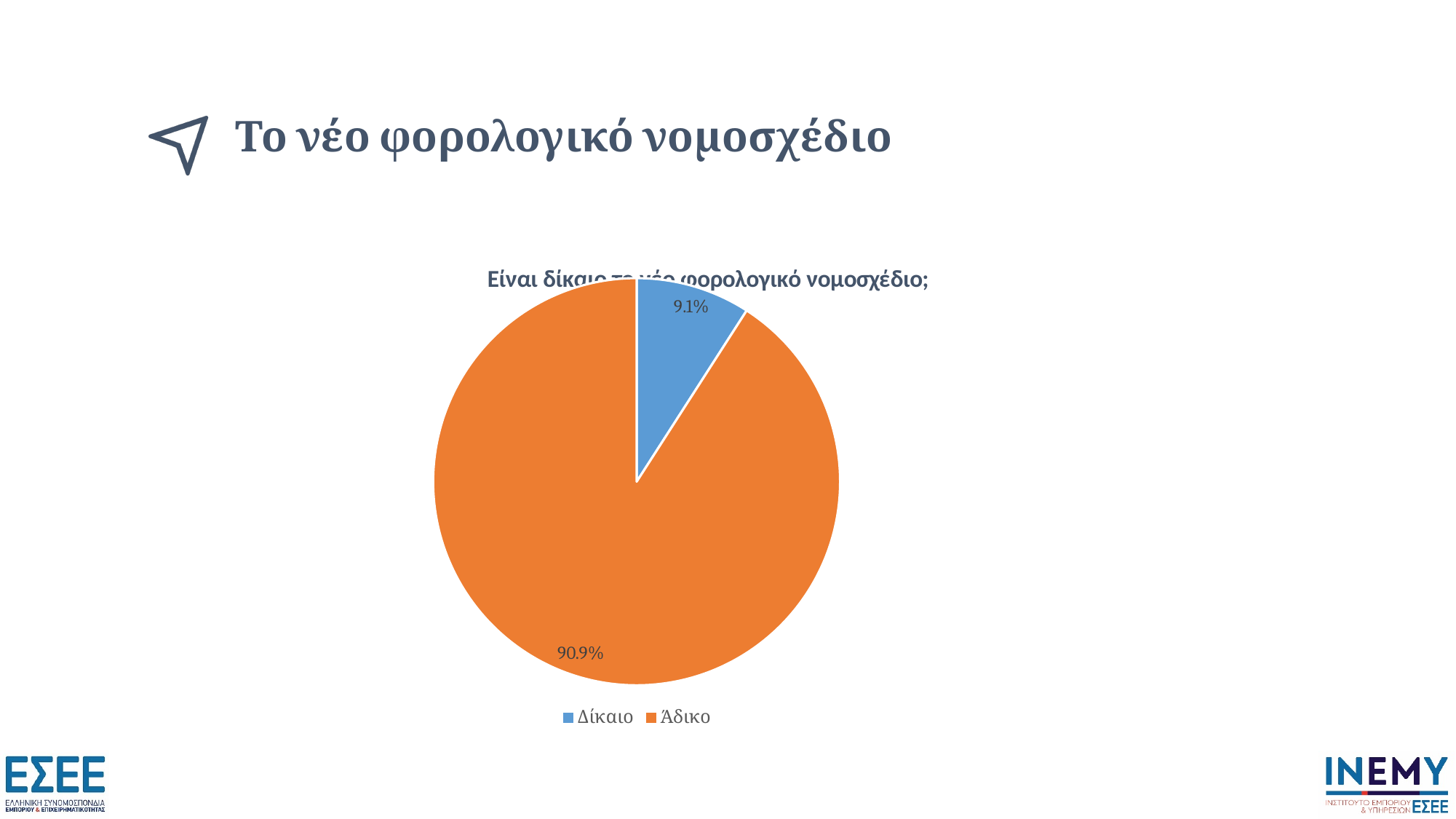
What percentage of the pie chart corresponds to Δίκαιο? 9.1% Which is larger, the share for Δίκαιο or the share for Άδικο? Άδικο Which category has the largest share of the pie chart? Άδικο What is the total of the two slices shown in the pie chart? 100% What is the difference in percentage points between Άδικο and Δίκαιο? 81.8 What percentage of the pie chart corresponds to Άδικο? 90.9% What kind of chart is shown on the slide? pie chart What is the title of the chart? Είναι δίκαιο το νέο φορολογικό νομοσχέδιο; How many entries does the legend list? 2 What colour is the slice for Άδικο? orange How many categories does the pie chart show? 2 Which category has the smallest share of the pie chart? Δίκαιο